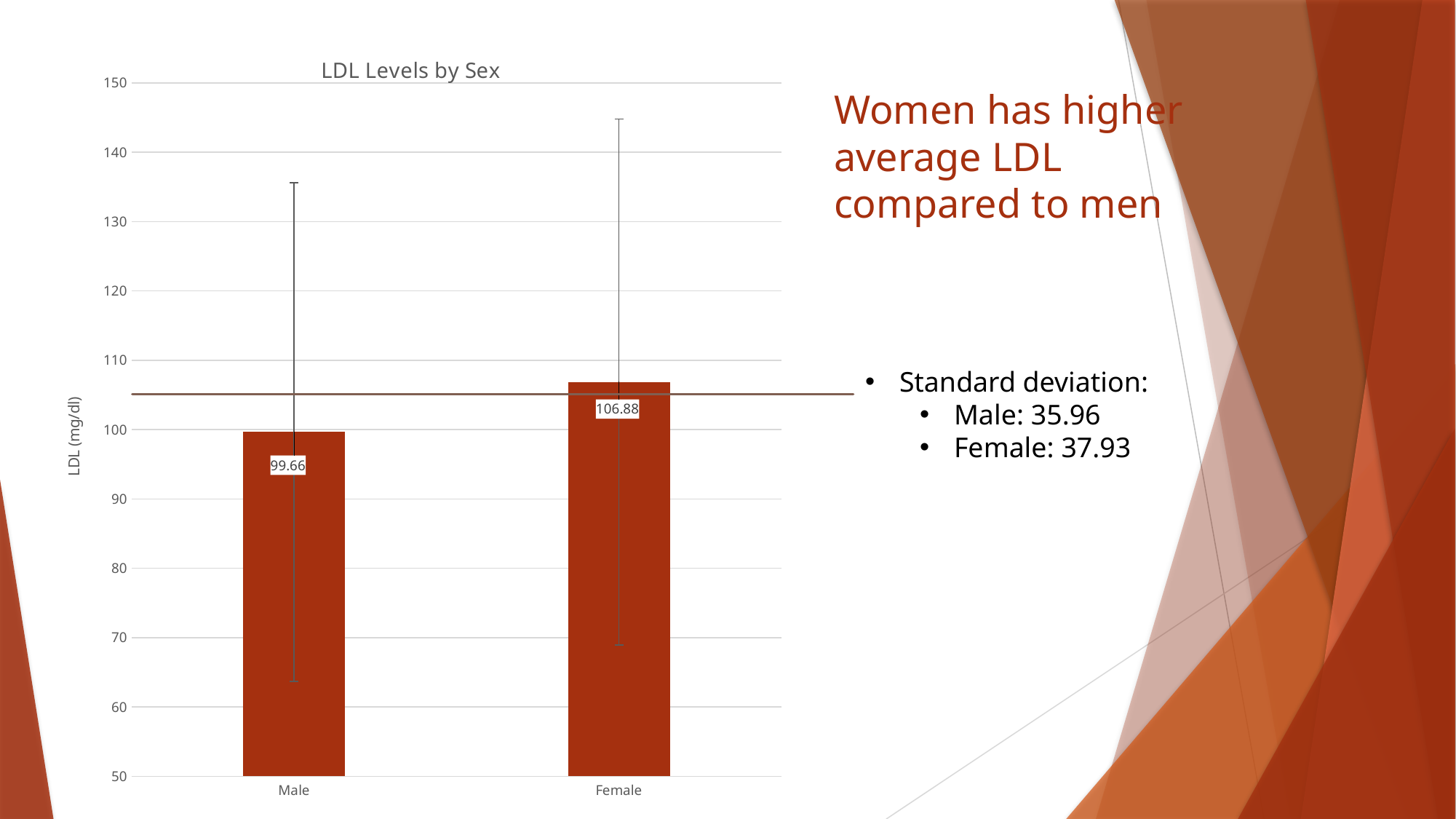
What is the difference between the Female and Male LDL values? 7.22 Which category has the higher LDL level? Female How many categories are shown on the x axis? 2 What is the title of the chart? LDL Levels by Sex Is the value for Female greater or less than 100? greater Is the LDL value for Male larger or smaller than the value for Female? smaller What is the LDL value for Female? 106.88 What is the LDL value for Male? 99.66 Is the value for Male greater or less than 100? less What kind of chart is shown on the slide? bar chart What is the label of the y axis? LDL (mg/dl) Which category has the lower LDL level? Male